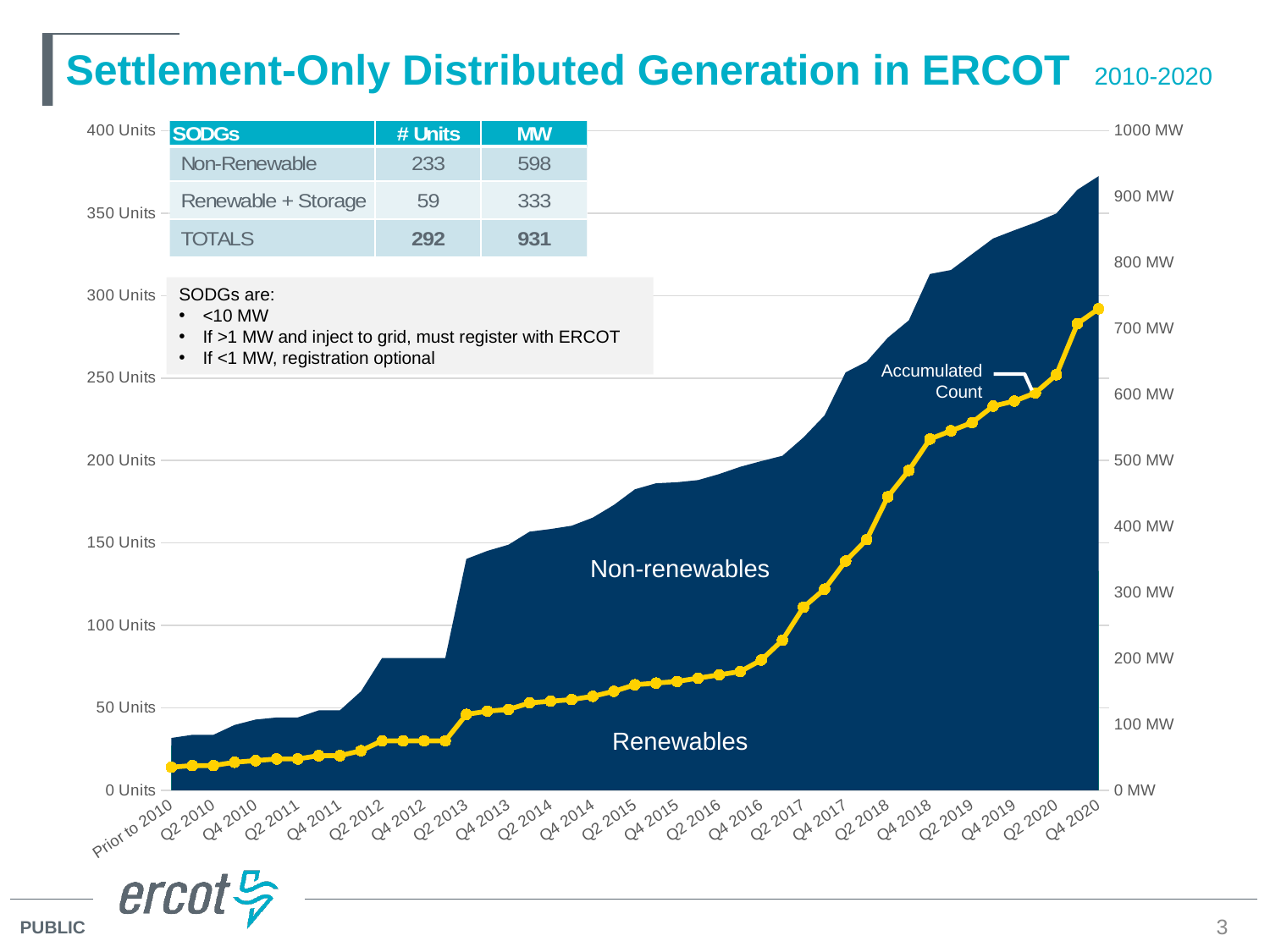
Which series is plotted as the yellow line with markers? Accumulated Count How many labels are shown on the x axis of the chart? 23 Is the total MW (top of the stacked area) at Q4 2013 greater or less than 300 MW? greater Is the Accumulated Count at Q4 2020 greater or less than 250 Units? greater What kind of chart is shown on the slide? A combination area and line chart Is the total MW (top of the stacked area) at Q4 2020 greater or less than 900 MW? greater Does the Accumulated Count rise or fall from Prior to 2010 to Q4 2020? Rises What is the highest tick value shown on the right-hand MW axis? 1000 MW At Q4 2020, which contributes more MW: Renewables or Non-renewables? Non-renewables How many data series are plotted on the chart? 3 Which area series is stacked on top of the other in the chart? Non-renewables